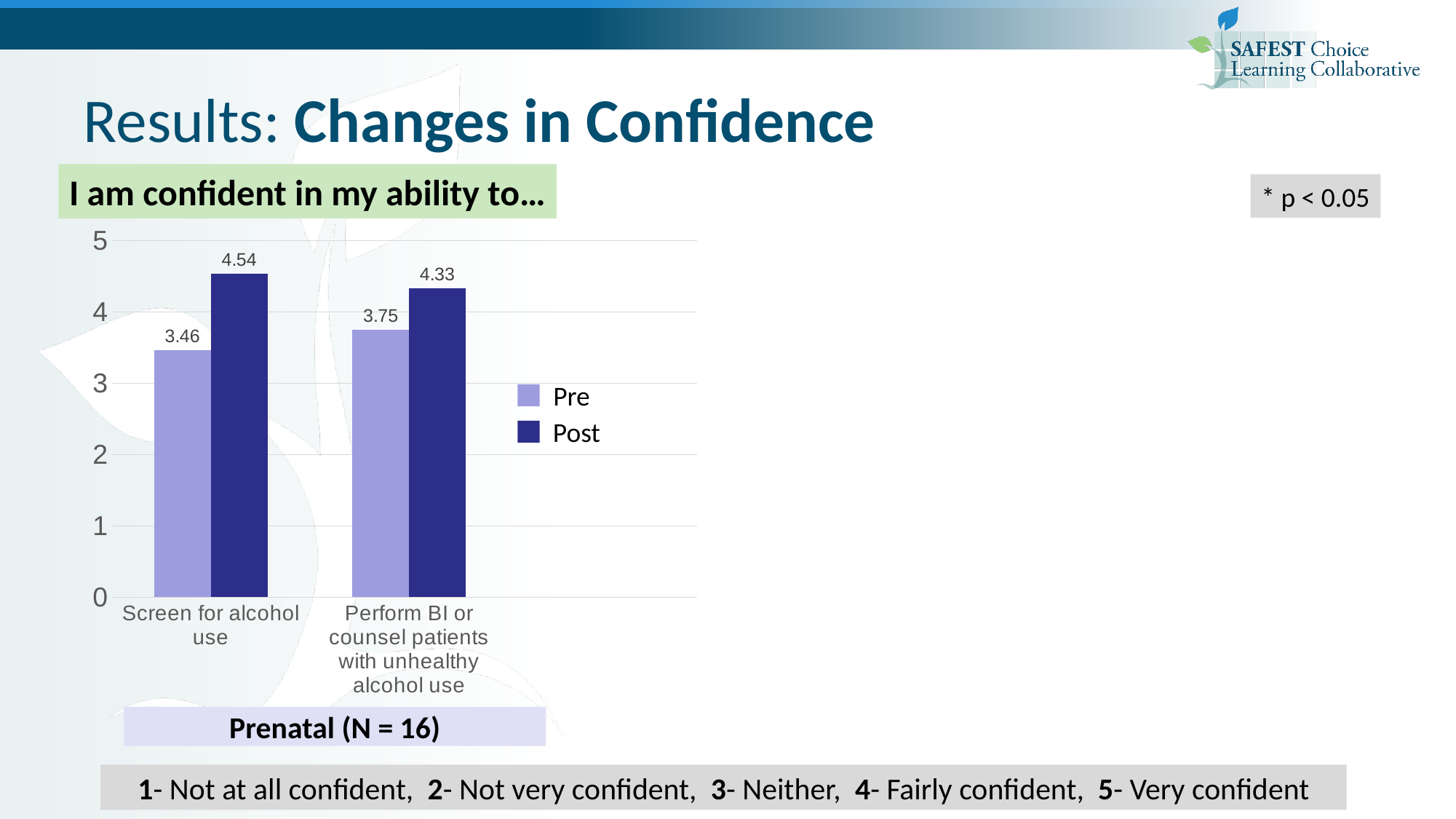
How many series does the chart legend list? 2 How many categories are shown on the x axis of the chart? 2 What is the Pre value for 'Perform BI or counsel patients with unhealthy alcohol use'? 3.75 What is the Post value for 'Perform BI or counsel patients with unhealthy alcohol use'? 4.33 What is the difference between the Post and Pre values for 'Perform BI or counsel patients with unhealthy alcohol use'? 0.58 Which bar has the highest value on the chart? Post, Screen for alcohol use Which bar has the lowest value on the chart? Pre, Screen for alcohol use Which is larger: the Pre value for 'Screen for alcohol use' or the Pre value for 'Perform BI or counsel patients with unhealthy alcohol use'? Perform BI or counsel patients with unhealthy alcohol use What is the Post value for 'Screen for alcohol use'? 4.54 What is the difference between the Post and Pre values for 'Screen for alcohol use'? 1.08 What kind of chart is shown on the slide? Bar chart What is the Pre value for 'Screen for alcohol use'? 3.46